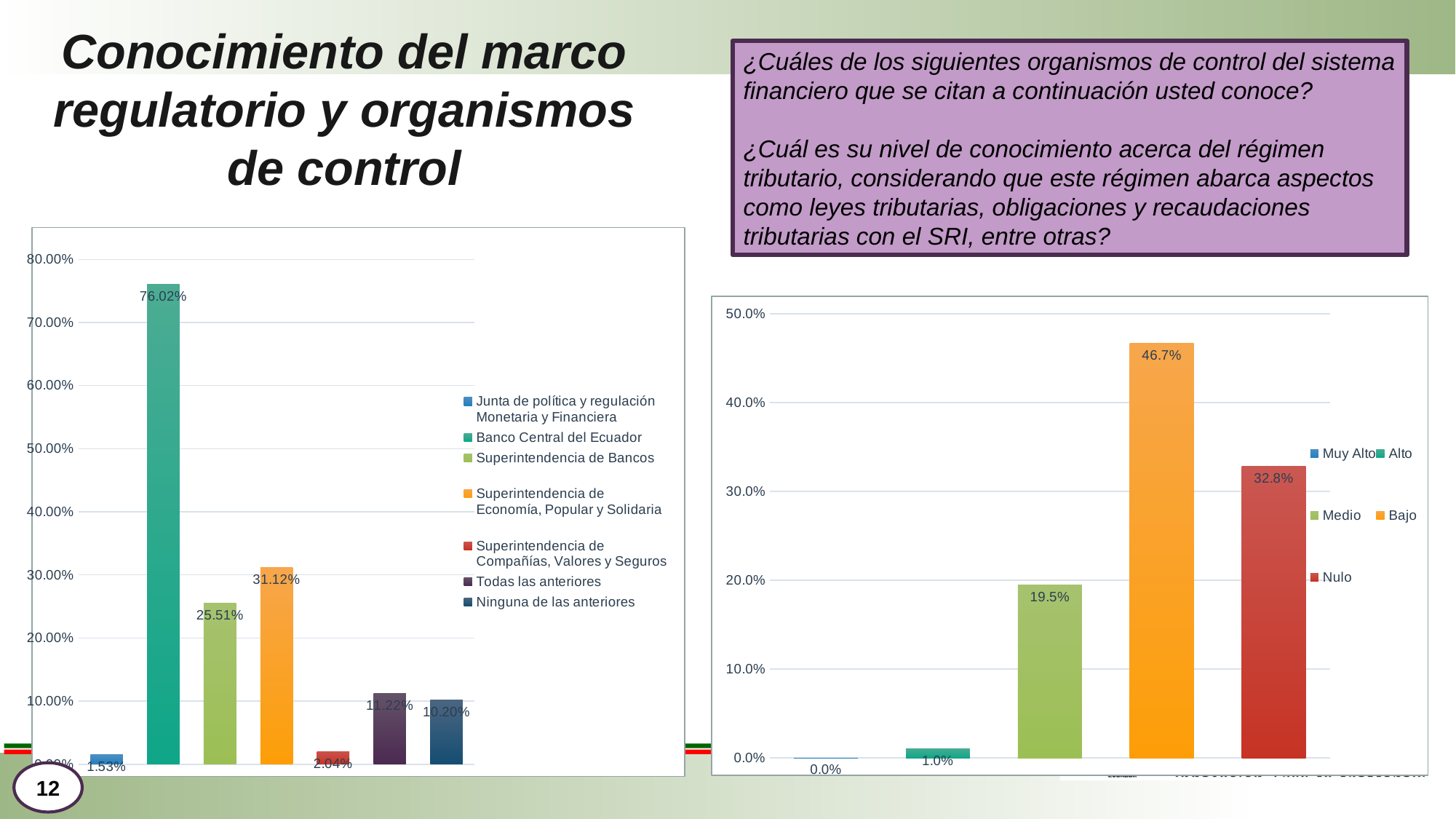
In the left chart, what is the difference between Superintendencia de Economía, Popular y Solidaria and Superintendencia de Bancos? 5.61% In the left chart, which is larger: Todas las anteriores or Ninguna de las anteriores? Todas las anteriores In the left chart, which category has the lowest value? Junta de política y regulación Monetaria y Financiera In the right chart, what is the difference between Bajo and Nulo? 13.9% In the left chart, which category has the highest value? Banco Central del Ecuador In the left chart, what is the value for Superintendencia de Economía, Popular y Solidaria? 31.12% In the left chart, what is the value for Banco Central del Ecuador? 76.02% In the right chart, which category has the highest value? Bajo In the right chart, what is the value for Bajo? 46.7% In the left chart, how many series does the legend list? 7 What type of chart is the right chart? Bar chart In the right chart, what is the value for Medio? 19.5%